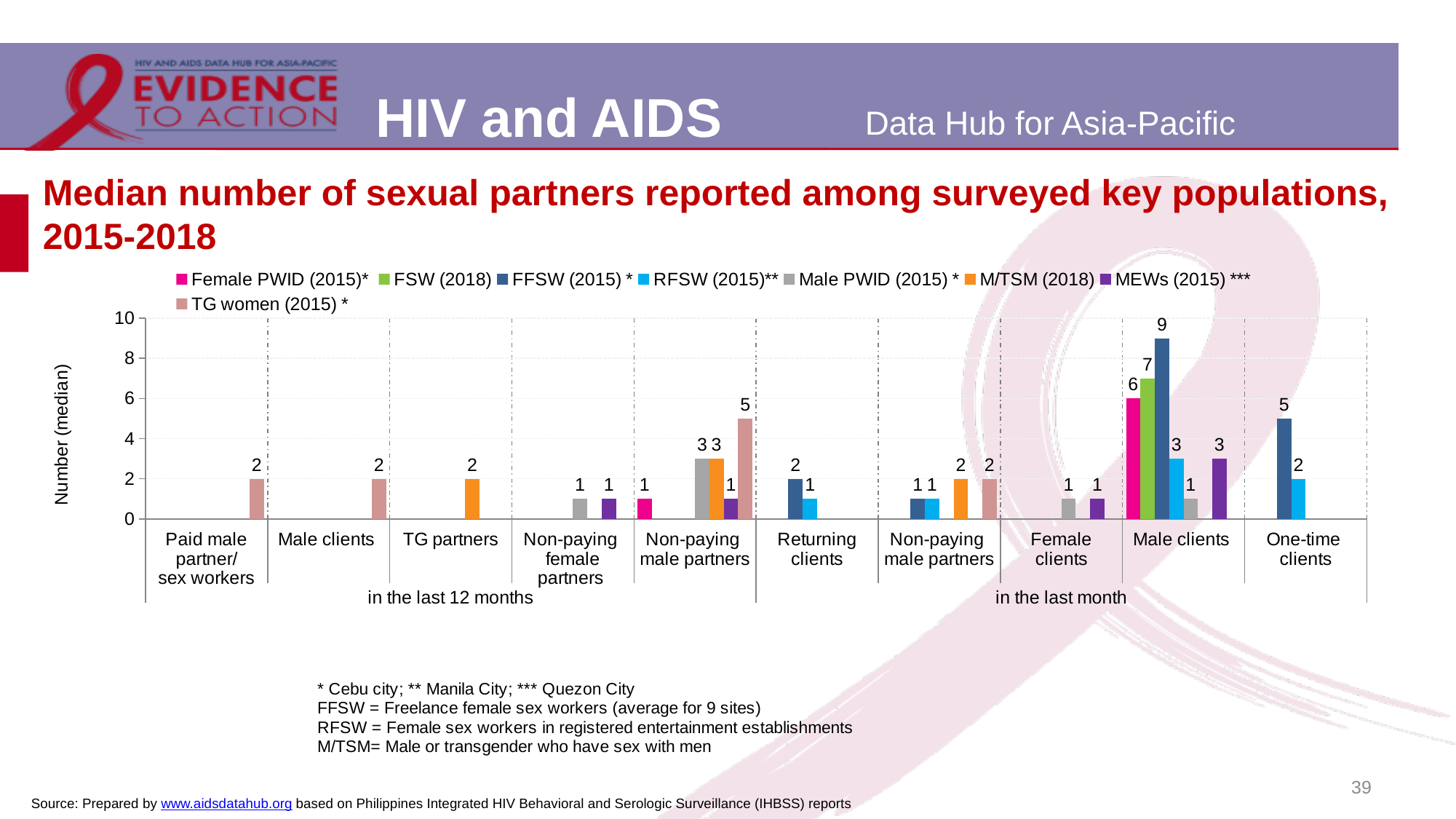
What type of chart is shown on the slide? bar chart What is the median number of one-time clients in the last month for RFSW (2015)? 2 What is the median number of non-paying male partners in the last 12 months for TG women (2015)? 5 What is the median number of male clients in the last month for FSW (2018)? 7 What is the median number of returning clients in the last month for FFSW (2015)? 2 What is the median number of male clients in the last month for FFSW (2015)? 9 For one-time clients in the last month, which is larger: the FFSW (2015) value or the RFSW (2015) value? FFSW (2015) * What is the difference between the TG women (2015) and Male PWID (2015) medians for non-paying male partners in the last 12 months? 2 What is the difference between the FFSW (2015) and Female PWID (2015) medians for male clients in the last month? 3 Which series has the highest median number of male clients in the last month? FFSW (2015) * How many series does the legend list? 8 What is the label of the y-axis? Number (median)